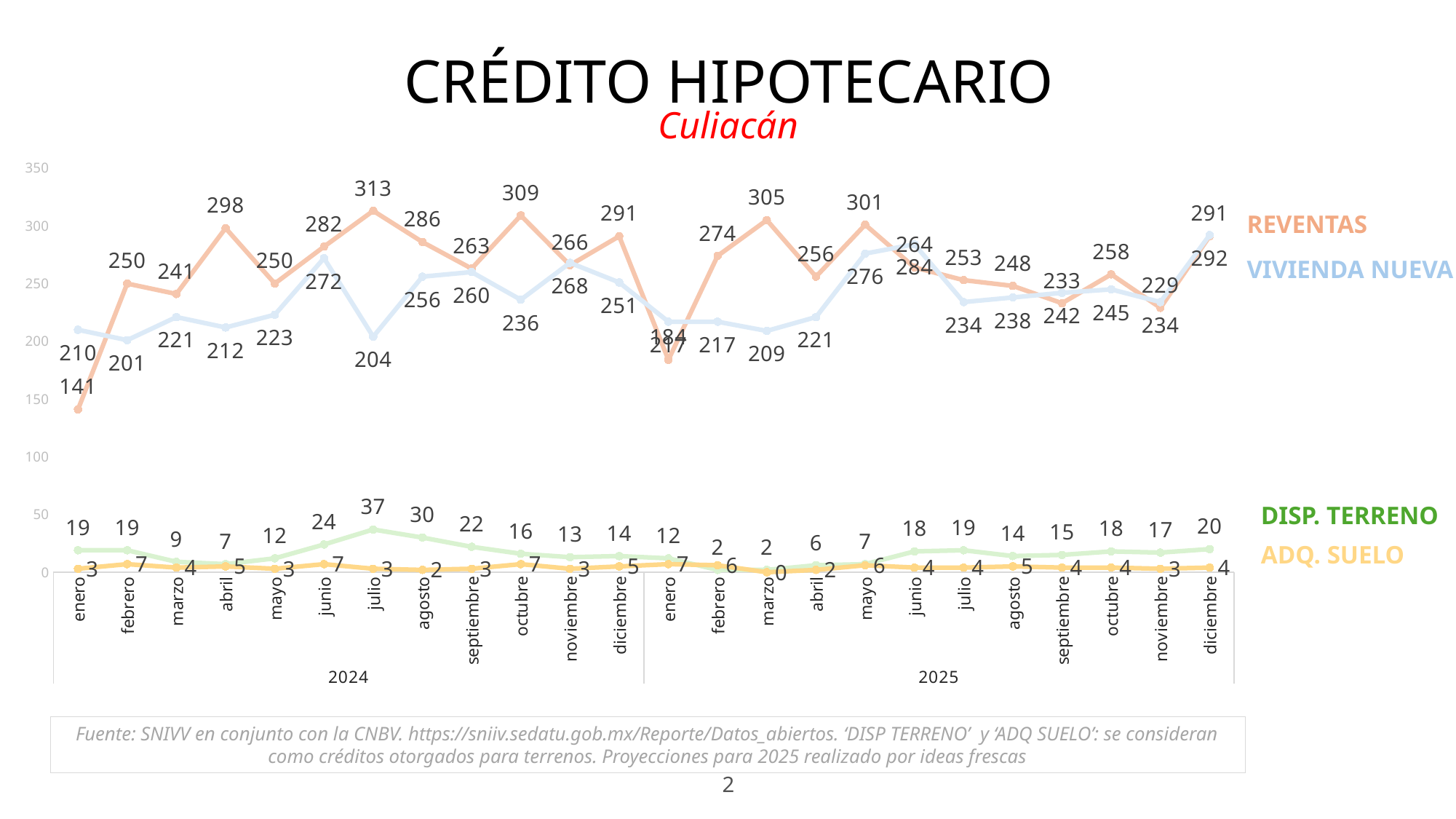
How many monthly data points does each series have? 24 In which month does DISP. TERRENO reach its highest value? julio 2024 What is the ADQ. SUELO value for marzo 2025? 0 In enero 2024, which is larger, REVENTAS or VIVIENDA NUEVA? VIVIENDA NUEVA What is the REVENTAS value for julio 2024? 313 In which month is the REVENTAS series highest? julio 2024 In which month is the REVENTAS series lowest? enero 2024 What kind of chart is shown on the slide? line chart Which city is named in the subtitle of the chart? Culiacán What is the difference between REVENTAS and VIVIENDA NUEVA in julio 2024? 109 What is the VIVIENDA NUEVA value for diciembre 2025? 292 How many series does the chart show? 4